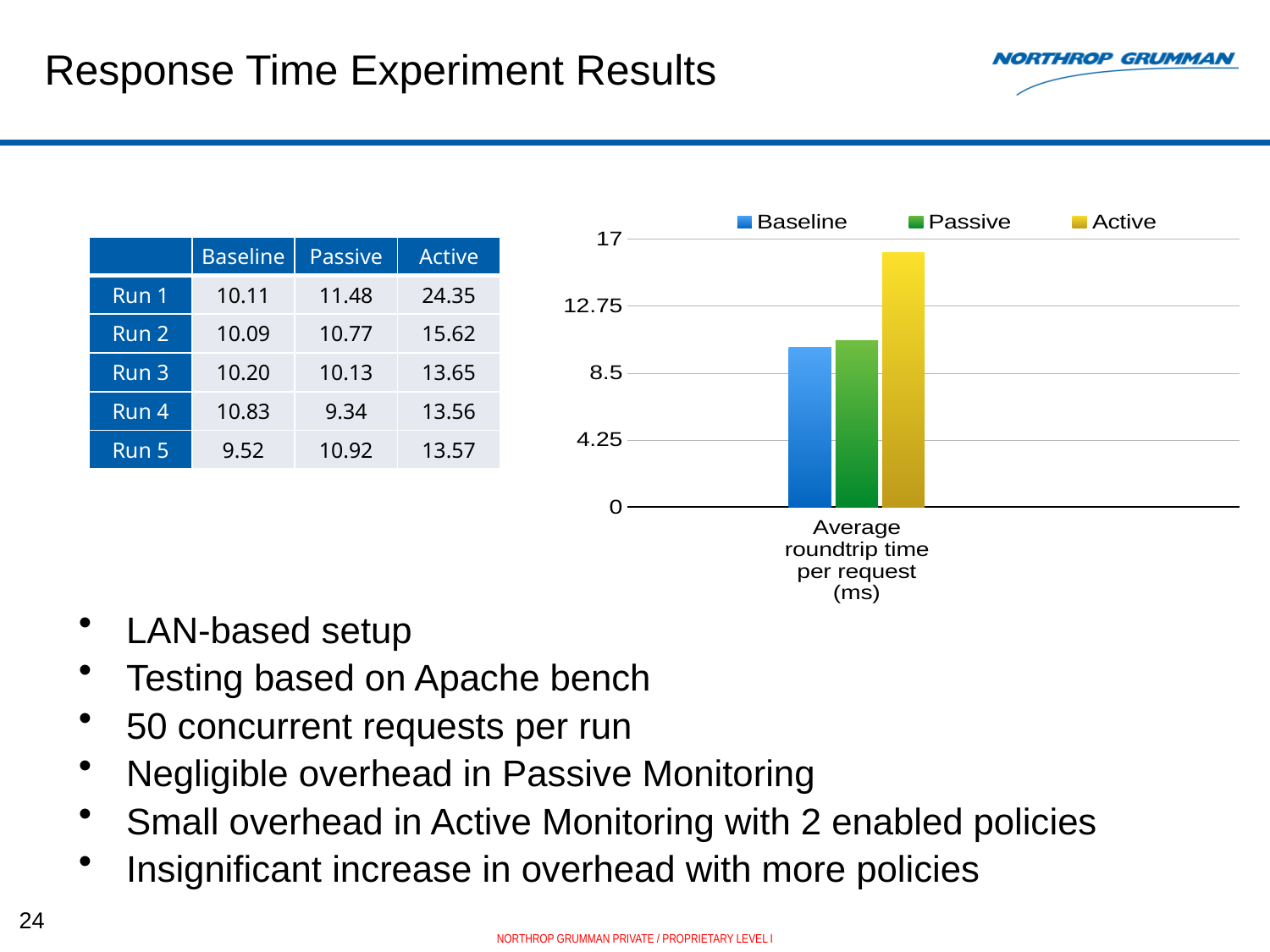
How many categories are plotted along the x axis of the chart? 1 Which series has the highest bar in the chart? Active What kind of chart is shown on the slide? bar chart How many series does the chart's legend list? 3 Is the bar for Active greater or less than 17? less What colour represents the Active series in the chart's legend? yellow Which is larger in the chart, the Passive bar or the Active bar? Active What is the label of the category on the x axis of the chart? Average roundtrip time per request (ms) Is the bar for Active greater or less than 12.75? greater Which is larger in the chart, the Active bar or the Baseline bar? Active Is the bar for Baseline greater or less than 8.5? greater